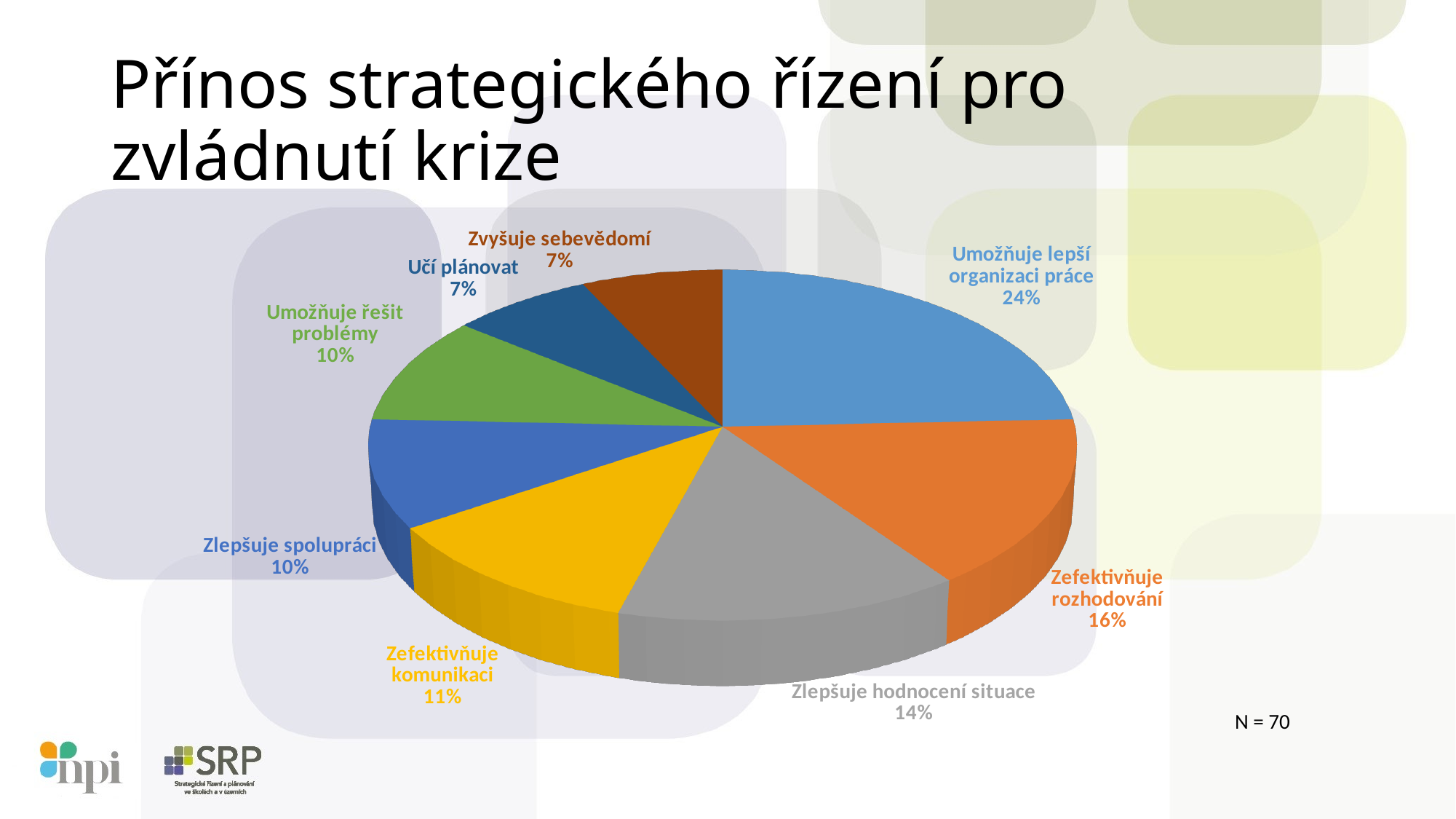
What is the value shown for "Zlepšuje hodnocení situace"? 14% Which is larger, the value for "Zlepšuje hodnocení situace" or the value for "Zefektivňuje komunikaci"? Zlepšuje hodnocení situace What sample size (N) is stated on the slide? N = 70 What is the value shown for "Zefektivňuje rozhodování"? 16% What is the title of the slide containing the chart? Přínos strategického řízení pro zvládnutí krize What is the difference between the values for "Umožňuje lepší organizaci práce" and "Zefektivňuje rozhodování"? 8% Which category has the largest slice of the pie? Umožňuje lepší organizaci práce What kind of chart is shown on the slide? Pie chart How many slices does the pie chart have? 8 What is the value shown for "Zefektivňuje komunikaci"? 11% What share of the pie does "Umožňuje lepší organizaci práce" have? 24% What is the value shown for "Učí plánovat"? 7%